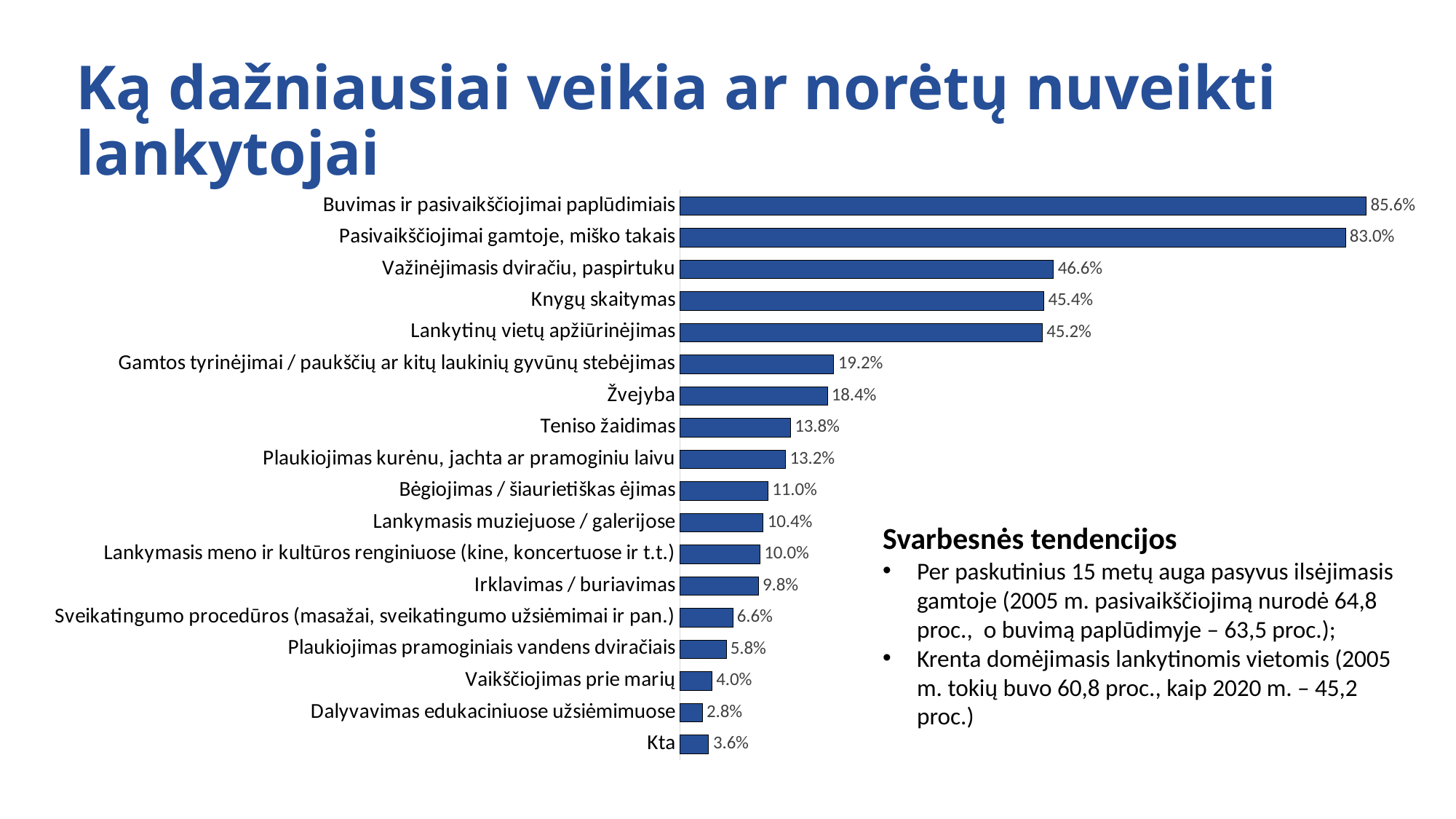
How many categories are shown in the chart? 18 What is the difference between the values for Buvimas ir pasivaikščiojimai paplūdimiais and Pasivaikščiojimai gamtoje, miško takais? 2.6% What kind of chart is shown on the slide? Bar chart What is the value for Lankytinų vietų apžiūrinėjimas? 45.2% What is the heading of the text box to the right of the chart? Svarbesnės tendencijos What is the value for Žvejyba? 18.4% Which is larger, the value for Teniso žaidimas or the value for Bėgiojimas / šiaurietiškas ėjimas? Teniso žaidimas What is the value for Buvimas ir pasivaikščiojimai paplūdimiais? 85.6% Which category has the lowest value? Dalyvavimas edukaciniuose užsiėmimuose Which category has the highest value? Buvimas ir pasivaikščiojimai paplūdimiais What is the difference between the values for Važinėjimasis dviračiu, paspirtuku and Gamtos tyrinėjimai / paukščių ar kitų laukinių gyvūnų stebėjimas? 27.4%